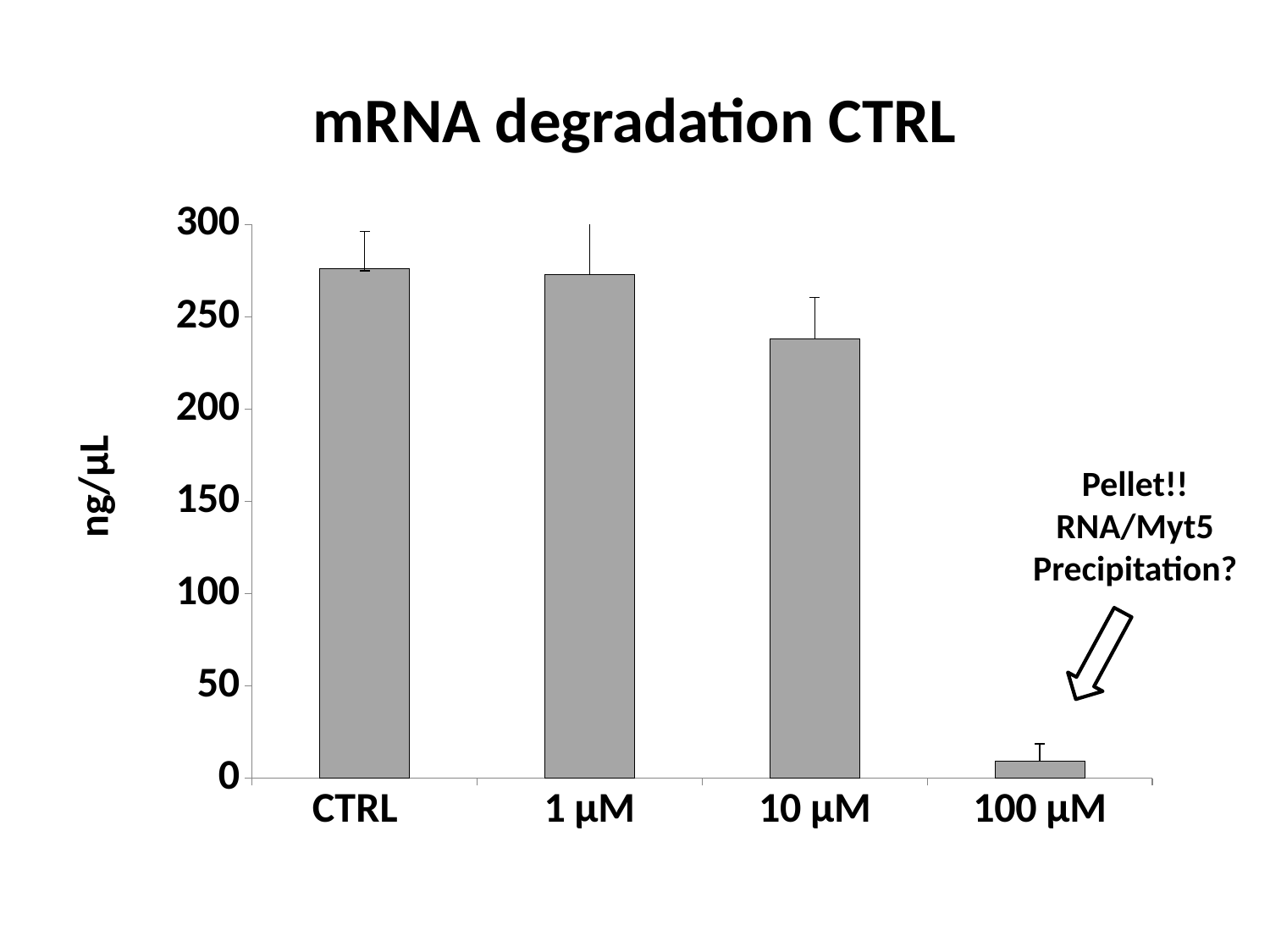
What is the label on the y axis of the chart? ng/µL How many categories are plotted on the x axis? 4 What is the title of the chart? mRNA degradation CTRL Do the values rise or fall moving from CTRL to 100 µM along the x axis? fall Is the value for 10 µM greater or less than 250? less Is the value for CTRL greater or less than 250? greater Is the value for 1 µM greater or less than 250? greater Which is larger, the value for CTRL or the value for 10 µM? CTRL What kind of chart is shown on the slide? bar chart Which category has the lowest value? 100 µM